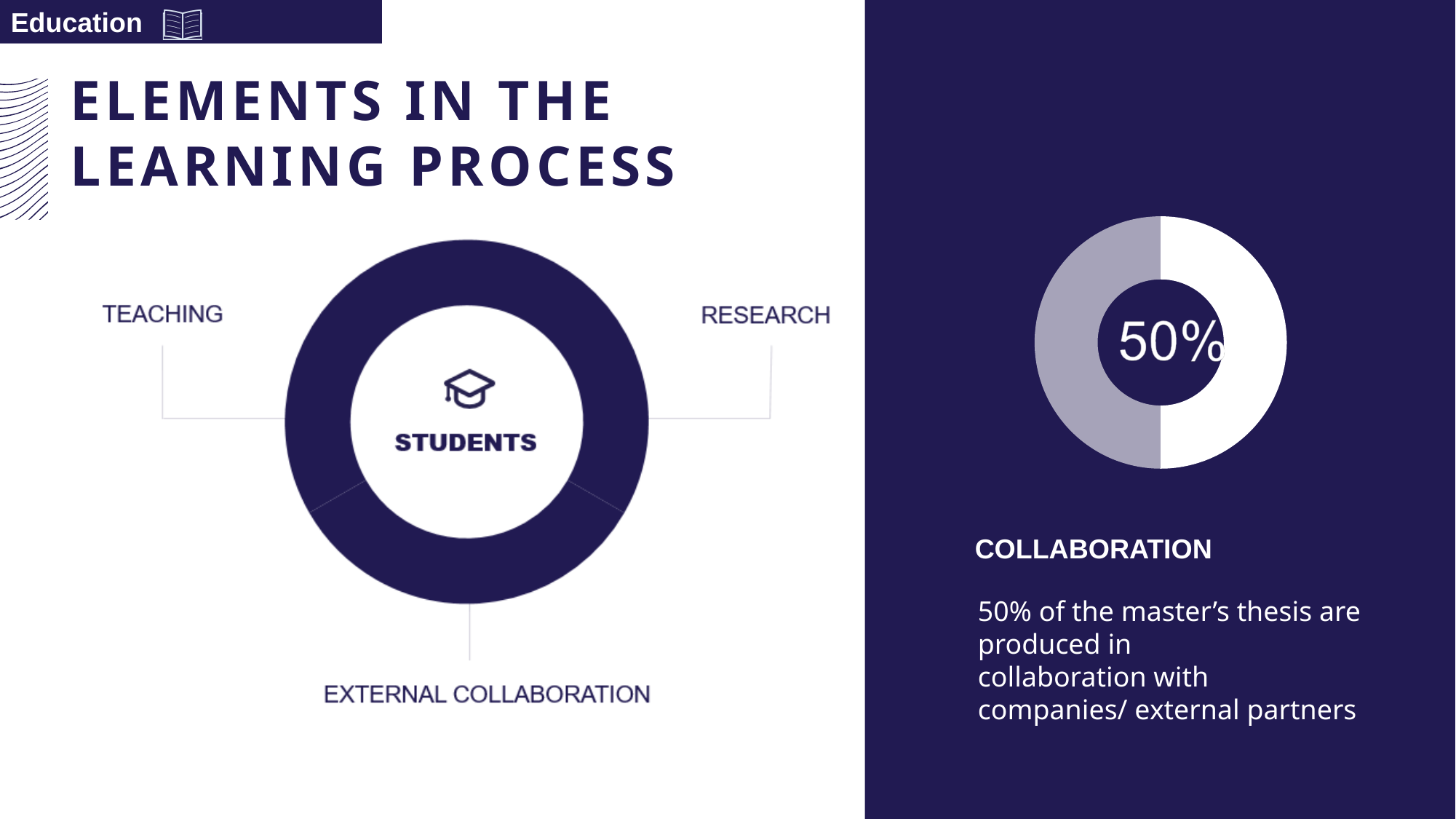
According to the text under the donut chart, what percentage of master's theses are produced in collaboration with companies/external partners? 50% In the ring diagram on the left, what label is in the centre of the ring? STUDENTS What kind of chart is shown on the right-hand side of the slide? Donut chart In the ring diagram on the left, how many elements are connected around the central 'STUDENTS' circle? 3 How many segments does the donut chart on the right have? 2 What heading appears below the donut chart on the right? COLLABORATION What percentage is printed in the centre of the donut chart on the right? 50% What share of the donut chart on the right is filled by the grey segment? 50%